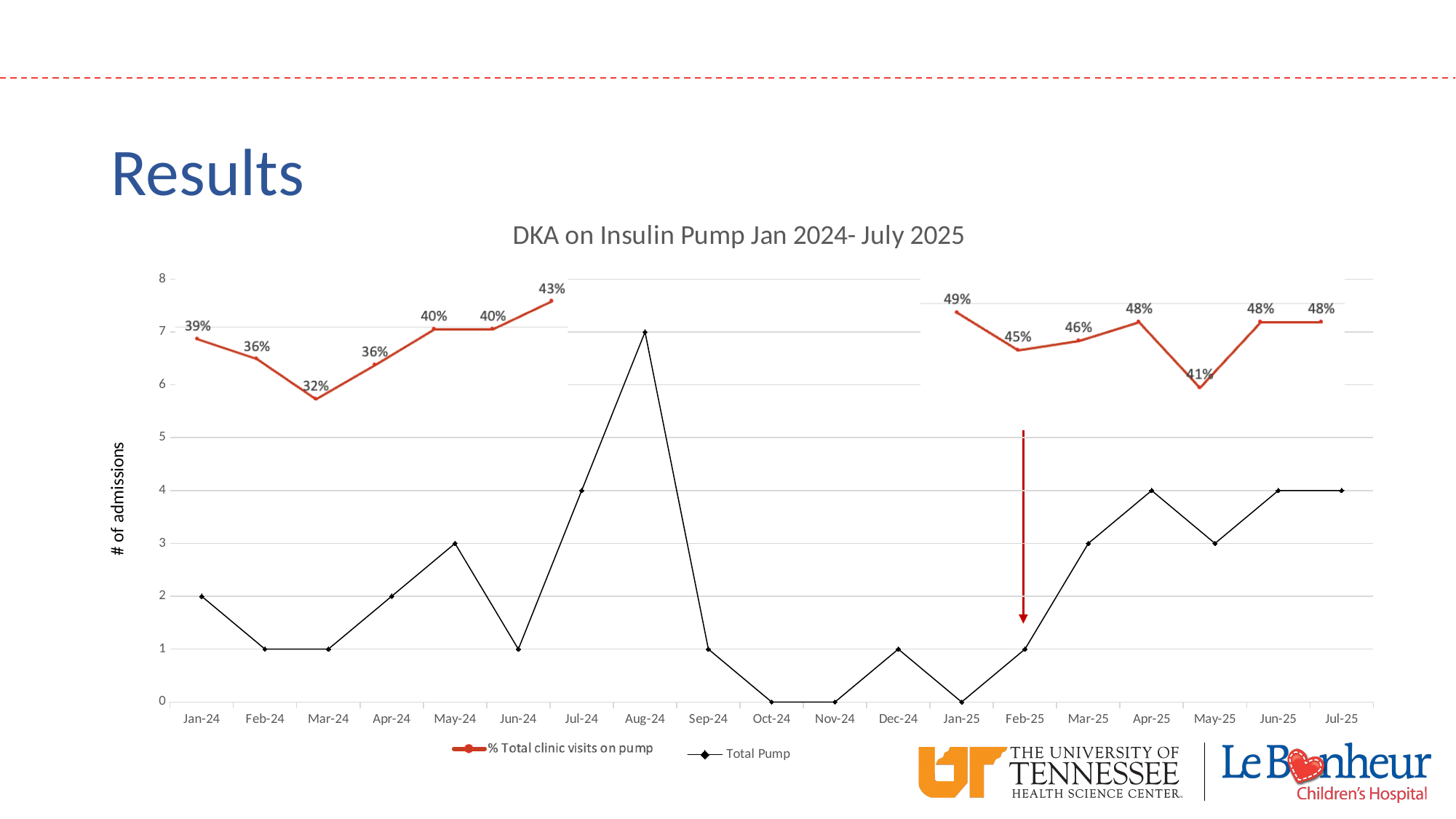
How many months are shown on the x axis of the chart? 19 What kind of chart is shown on the slide? Line chart Which month has the lowest % Total clinic visits on pump value among the labelled points? Mar-24 In which month is the Total Pump number of admissions highest? Aug-24 What is the difference between the % Total clinic visits on pump values for Jan-25 and Jan-24? 10% What is the Total Pump number of admissions in Aug-24? 7 Does the Total Pump number of admissions rise or fall from Jan-25 to Apr-25? Rise Which is larger, the Total Pump number of admissions in Jul-24 or in May-24? Jul-24 What is the title of the chart? DKA on Insulin Pump Jan 2024- July 2025 How many series does the chart legend list? 2 What is the % Total clinic visits on pump value for Jan-25? 49% What is the % Total clinic visits on pump value for Mar-24? 32%